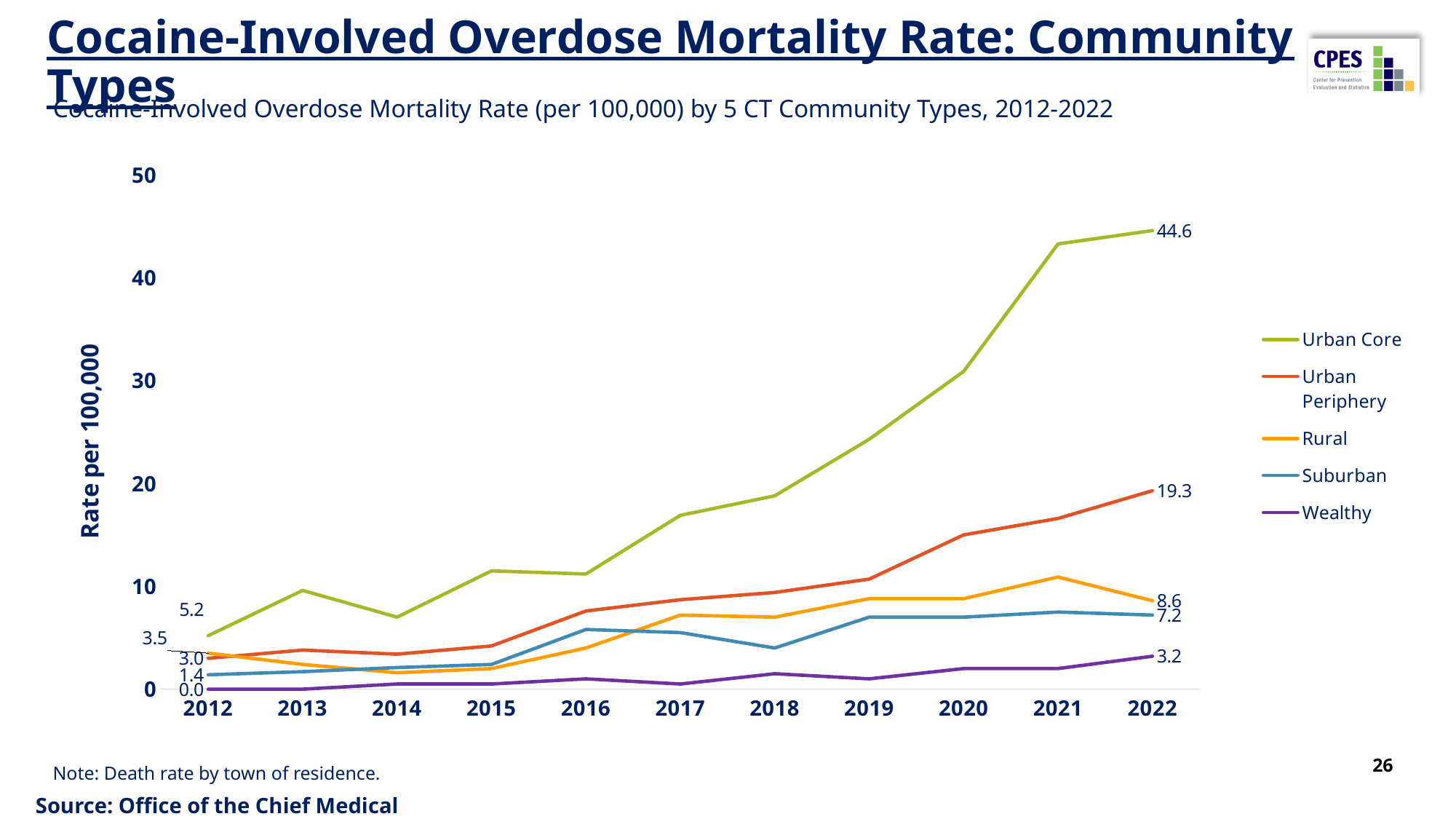
By how much did the Urban Core rate increase from 2012 to 2022? 39.4 How many community types does the legend list? 5 What kind of chart is shown on the slide? Line chart What is the rate for Rural in 2022? 8.6 What is the rate for Wealthy in 2022? 3.2 What was the Urban Core rate in 2012? 5.2 What is the rate for Urban Periphery in 2022? 19.3 Is the Urban Core rate in 2021 greater or less than 40? greater Which community type has the highest rate in 2022? Urban Core What is the rate for Suburban in 2022? 7.2 Which community type has the lowest rate in 2022? Wealthy What is the cocaine-involved overdose mortality rate for Urban Core in 2022? 44.6